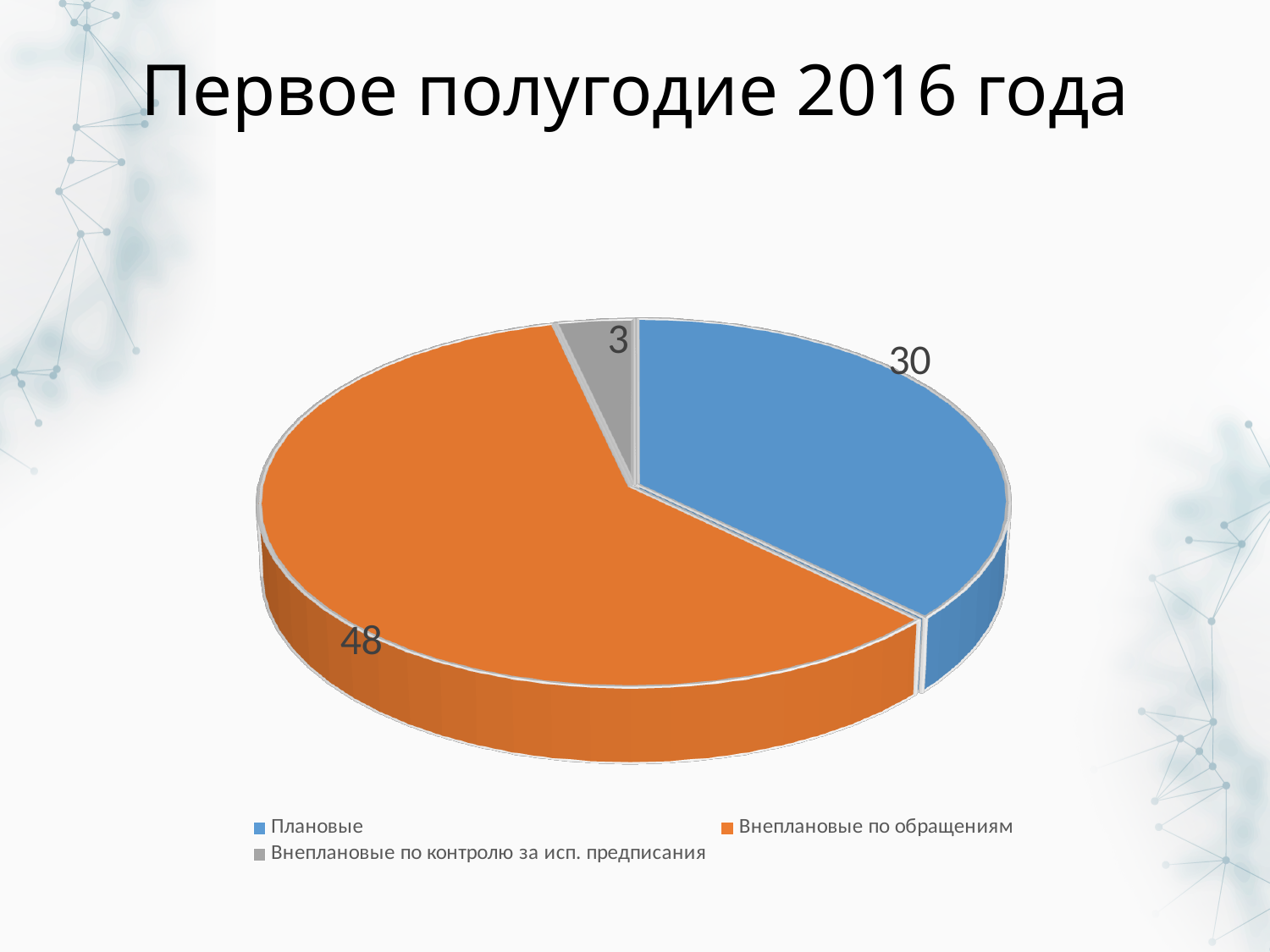
What is the difference between the Плановые and Внеплановые по контролю за исп. предписания values? 27 Which is larger, Плановые or Внеплановые по обращениям? Внеплановые по обращениям What is the value of the Внеплановые по обращениям slice? 48 What is the total of all slices in the pie chart? 81 What type of chart is shown on the slide? Pie chart How many slices does the pie chart have? 3 What is the value of the Внеплановые по контролю за исп. предписания slice? 3 What is the title of the chart on the slide? Первое полугодие 2016 года Which category has the largest slice of the pie? Внеплановые по обращениям What is the difference between the Внеплановые по обращениям and Плановые values? 18 What is the value of the Плановые slice? 30 Which category has the smallest slice of the pie? Внеплановые по контролю за исп. предписания